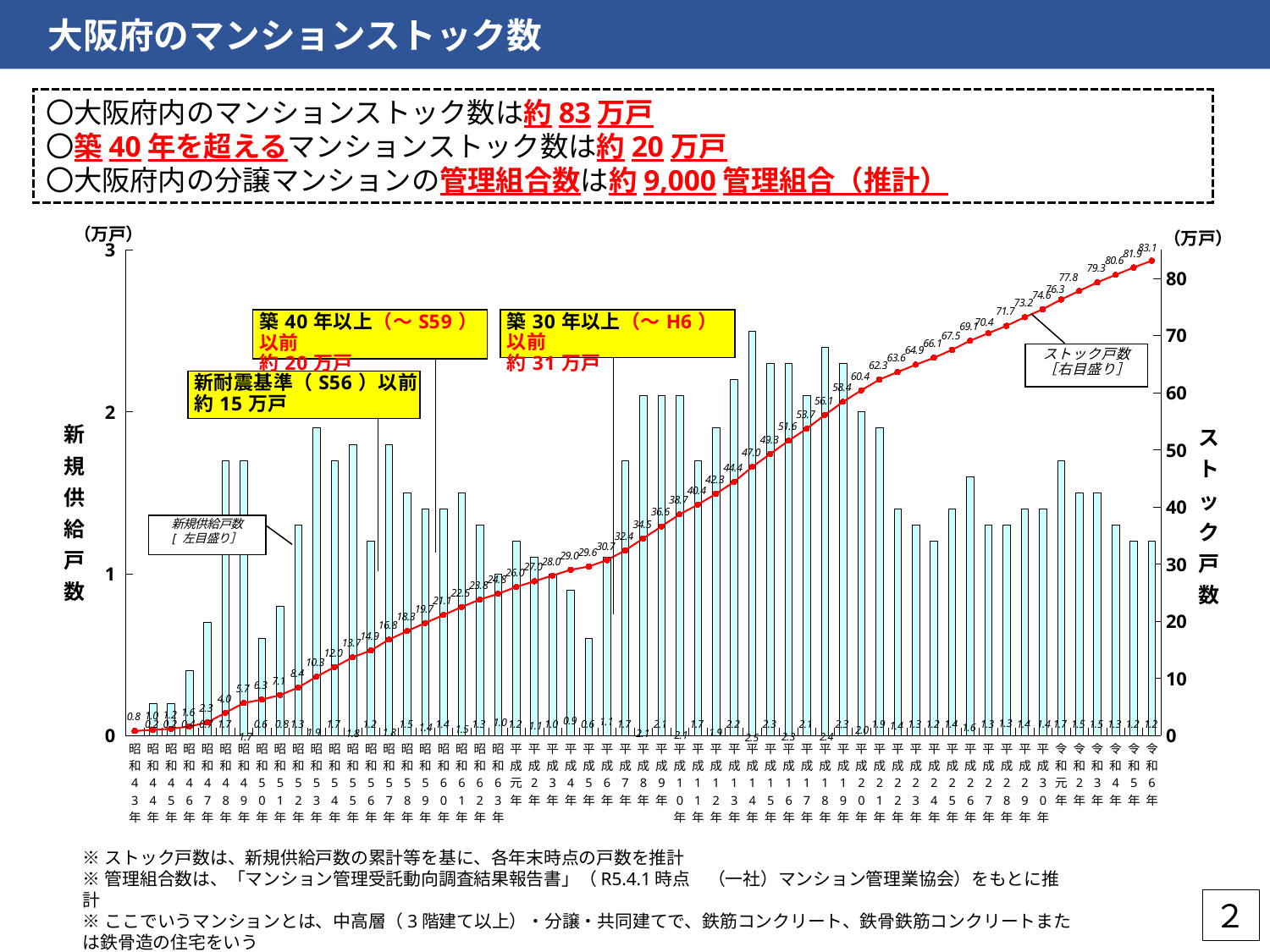
What is the ストック戸数 value for 平成6年? 30.7 Does the ストック戸数 line rise or fall from 昭和43年 to 令和6年? It rises What is the title of the slide's chart? 大阪府のマンションストック数 What is the difference between the ストック戸数 values for 令和6年 and 令和5年? 1.2 What kind of chart is shown on the slide? A combined bar and line chart How many data series are plotted on the chart? 2 What is the ストック戸数 value for 令和6年? 83.1 What is the ストック戸数 value for 昭和43年? 0.8 What is the ストック戸数 value for 昭和59年? 19.7 In which year is the ストック戸数 line at its highest? 令和6年 Is the ストック戸数 value for 平成10年 greater or less than 30? greater Which is larger, the ストック戸数 value for 平成元年 or for 昭和63年? 平成元年